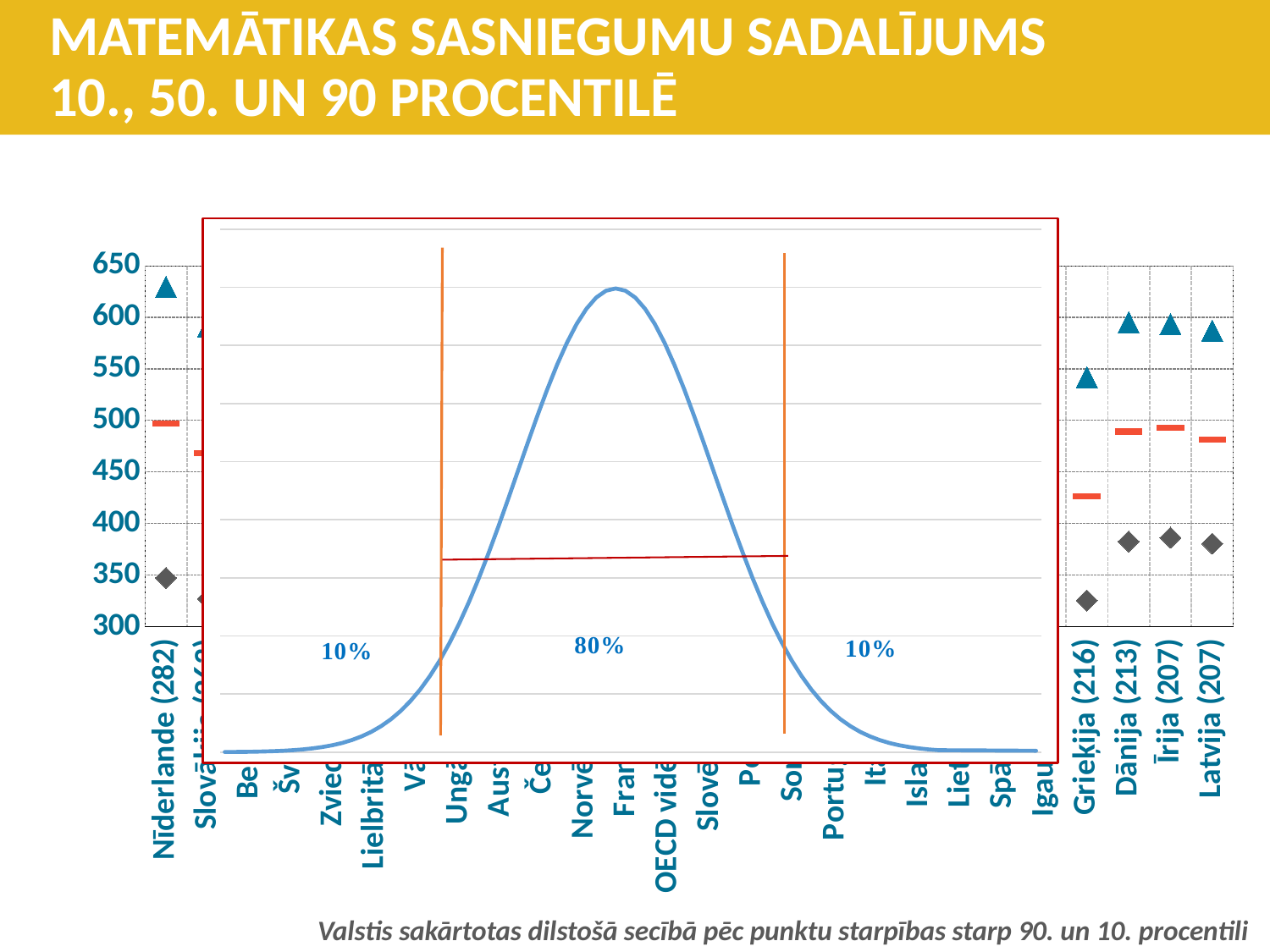
Is the value of the triangle marker for Nīderlande greater or less than 600? greater Is the value of the diamond marker for Nīderlande greater or less than 400? less What three percentages are labelled under the bell curve overlaid on the chart, from left to right? 10%, 80%, 10% Which has the higher triangle marker, Nīderlande or Grieķija? Nīderlande Is the value of the triangle marker for Latvija greater or less than 550? greater What number is shown in parentheses next to Dānija on the x axis? 213 What number is shown in parentheses next to Grieķija on the x axis? 216 What is the difference between the numbers in parentheses for Nīderlande (282) and Latvija (207)? 75 Which has the higher diamond marker, Grieķija or Dānija? Dānija What number is shown in parentheses next to Latvija on the x axis? 207 What number is shown in parentheses next to Nīderlande on the x axis? 282